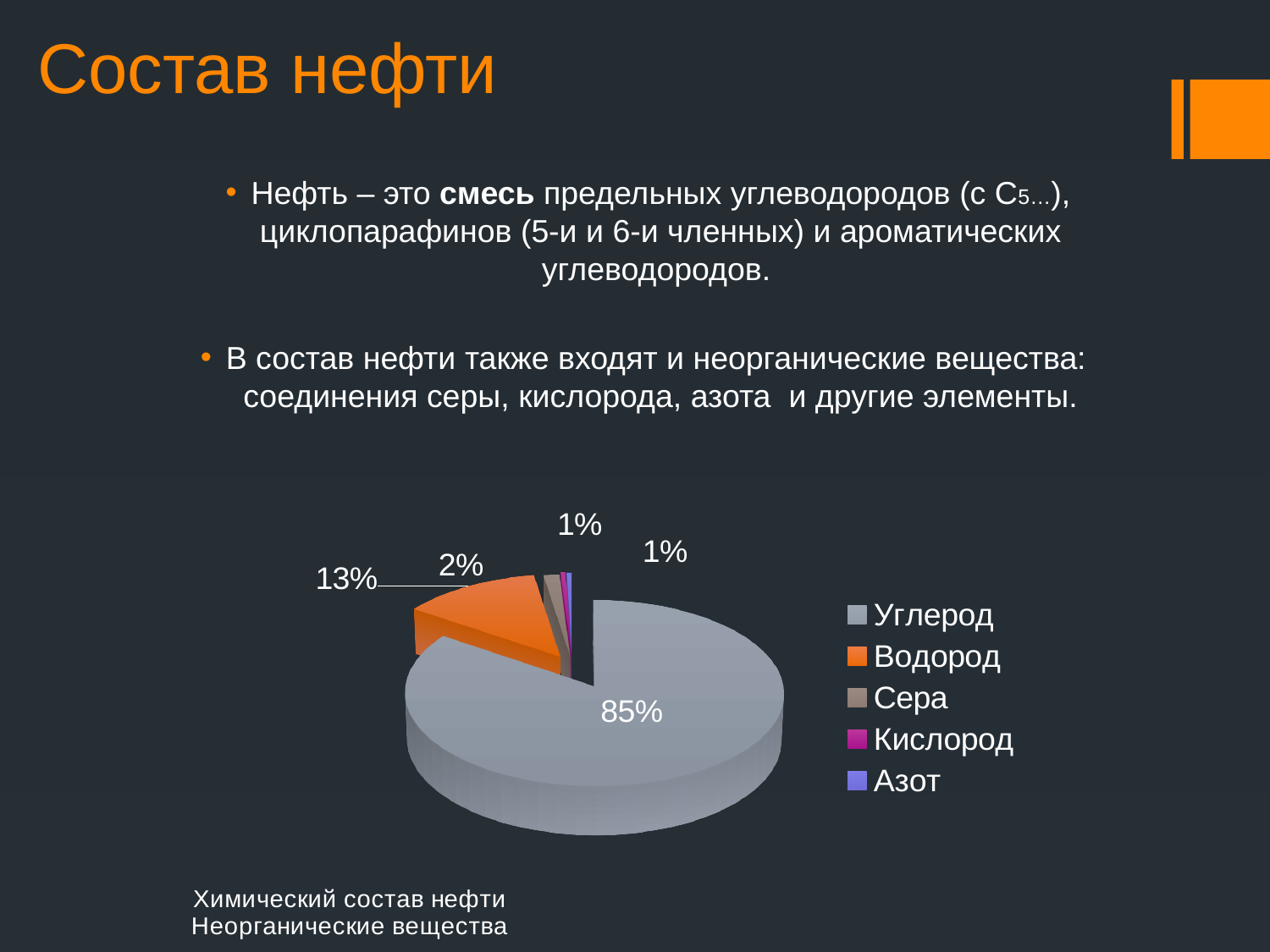
Which legend entry is listed last in the pie chart's legend? Азот How many entries does the legend of the pie chart list? 5 What colour is the Водород slice in the pie chart? orange What is the difference in percentage points between Углерод and Водород? 72 What is the value shown for Сера in the pie chart? 2% Which category has the largest slice in the pie chart? Углерод Is the value for Углерод greater or less than 50%? greater What is the value shown for Водород in the pie chart? 13% Which is larger in the pie chart, Водород or Сера? Водород How many slices does the pie chart have? 5 What kind of chart is shown on the slide? pie chart What share of the pie does Углерод take? 85%